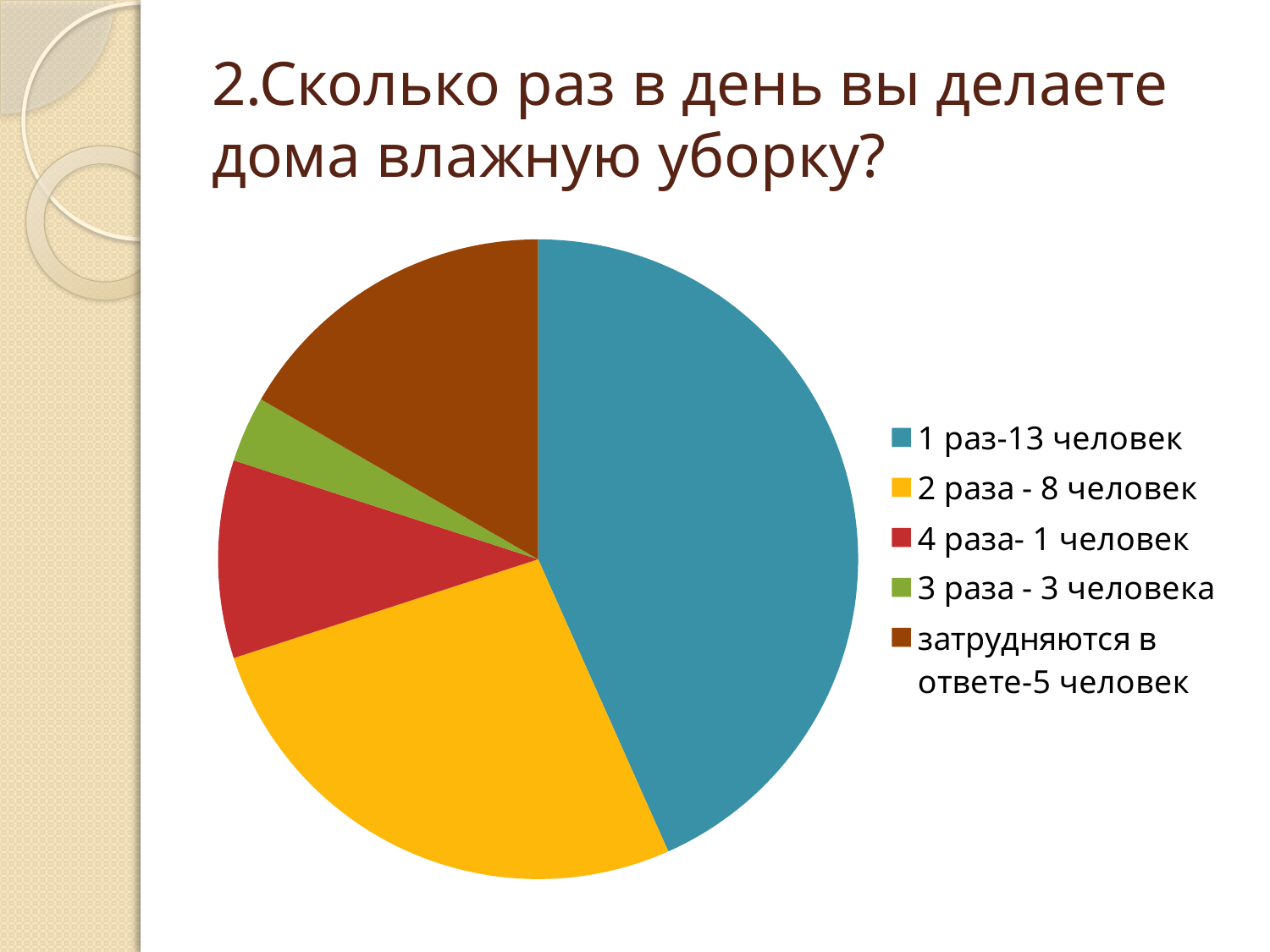
How many people answered "4 раза"? 1 человек How many people answered "2 раза"? 8 человек What colour is the slice for "2 раза - 8 человек"? yellow How many people answered "1 раз" according to the legend? 13 человек Which answer option has the largest slice of the pie? 1 раз-13 человек Which answer option has the smallest slice of the pie? 3 раза - 3 человека What kind of chart is shown on the slide? pie chart How many more people answered "1 раз" than "2 раза"? 5 How many people are listed as "затрудняются в ответе"? 5 человек How many people answered "3 раза"? 3 человека How many slices does the pie chart have? 5 Which is larger: the number of people who answered "3 раза" or those who "затрудняются в ответе"? затрудняются в ответе